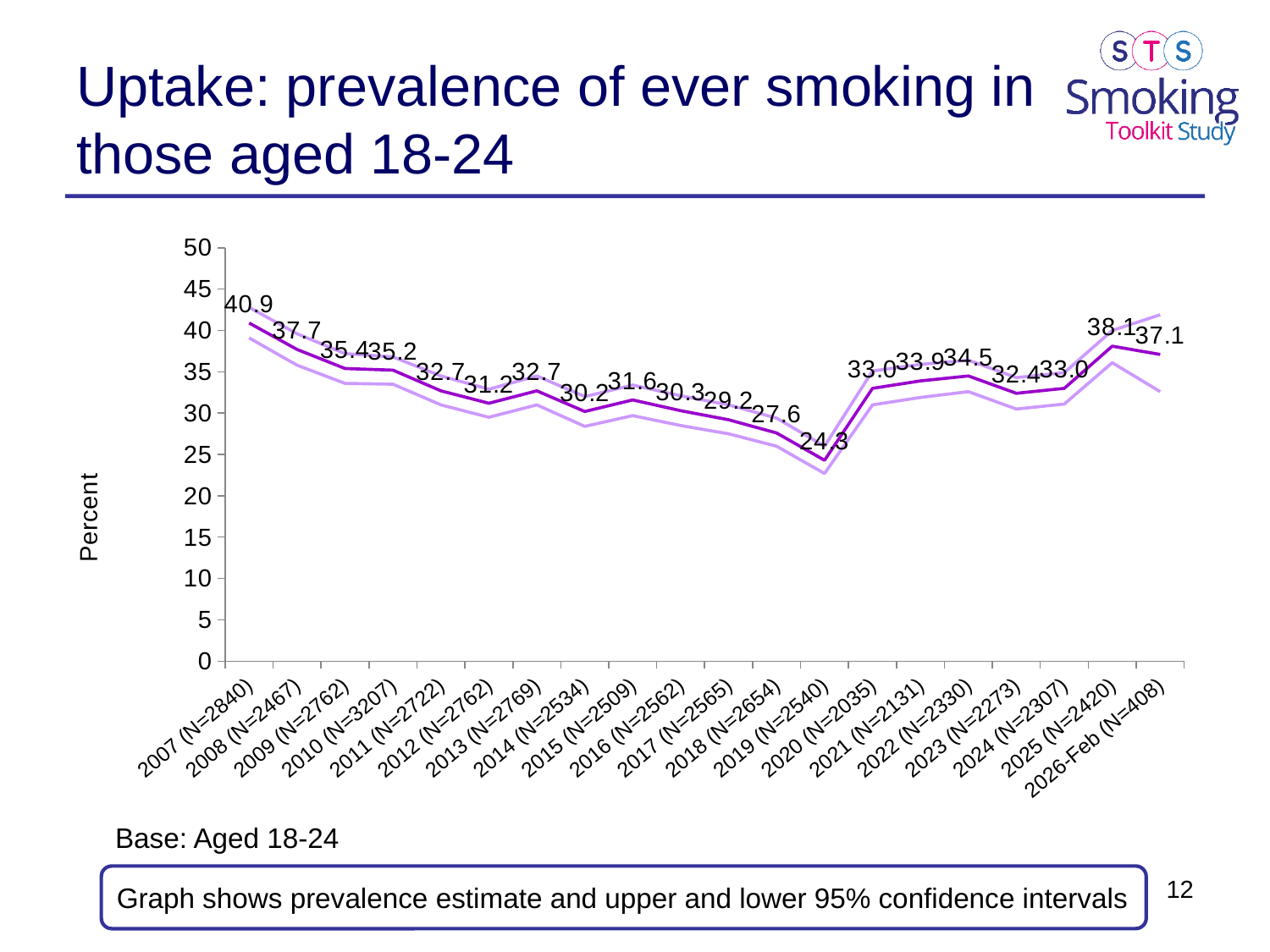
How many time points are plotted on the x axis? 20 What is the prevalence of ever smoking for 2025 (N=2420)? 38.1 What is the prevalence of ever smoking for 2007 (N=2840)? 40.9 What is the difference between the prevalence estimates for 2007 and 2019? 16.6 What kind of chart is shown on the slide? Line chart Which has the higher prevalence estimate, 2025 (N=2420) or 2026-Feb (N=408)? 2025 (N=2420) What is the difference between the prevalence estimates for 2025 and 2024? 5.1 What is the prevalence of ever smoking for 2019 (N=2540)? 24.3 Which year has the highest prevalence estimate? 2007 (N=2840) Which year has the lowest prevalence estimate? 2019 (N=2540) Does the prevalence estimate rise or fall from 2007 to 2019? Fall What is the label on the y axis? Percent